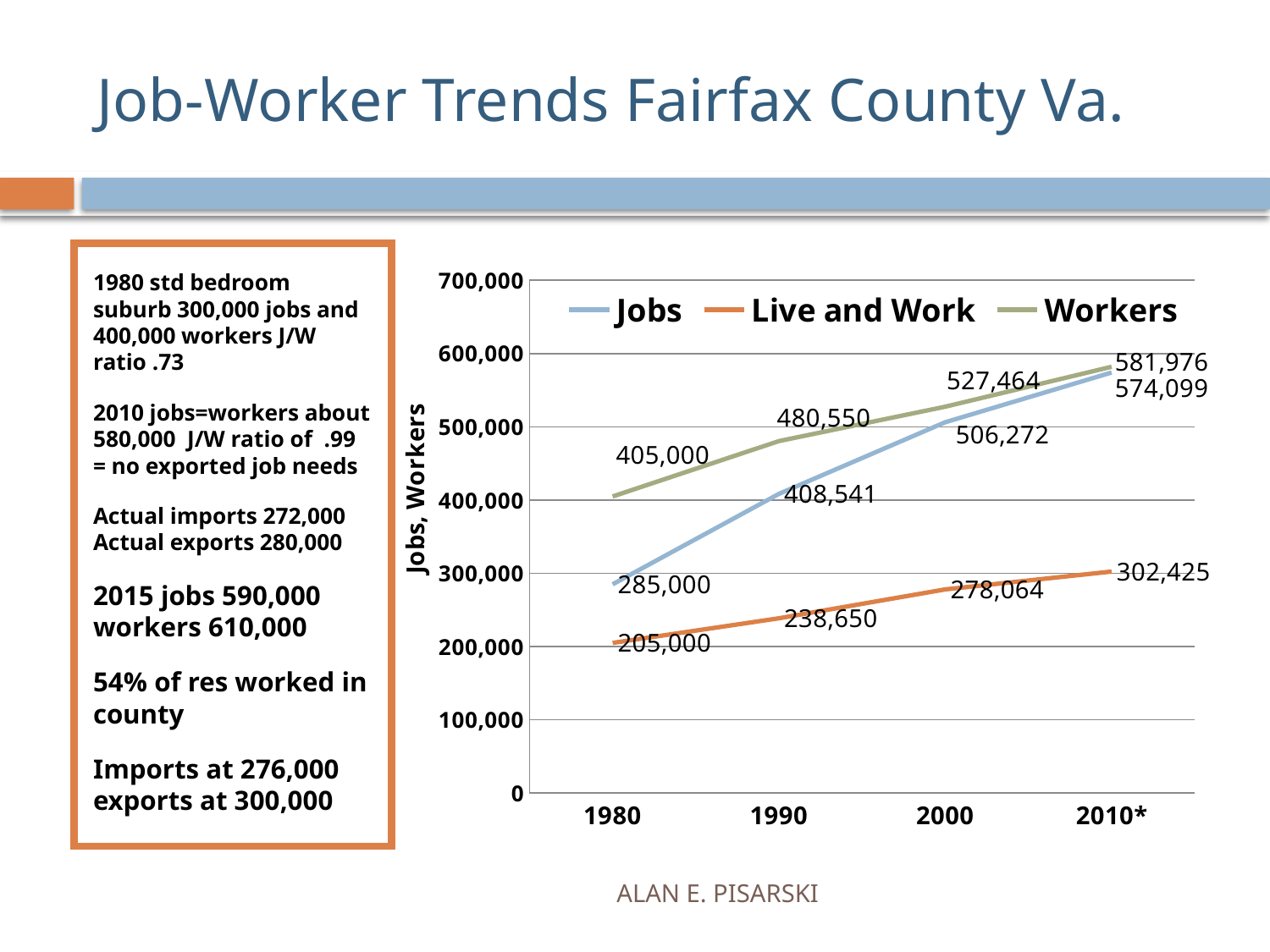
What is the value of Live and Work in 1990? 238,650 Which is larger in 1990, Jobs or Live and Work? Jobs What is the value of Jobs in 2000? 506,272 What type of chart is shown on the slide? line chart Does the Live and Work series rise or fall from 1980 to 2010*? rise What is the value of Jobs in 2010*? 574,099 How many years are shown on the x axis? 4 What is the difference between Workers and Jobs in 1980? 120,000 How many series does the chart legend list? 3 In which year is the Jobs series lowest? 1980 In which year is the Workers series highest? 2010* What is the value of Workers in 1980? 405,000